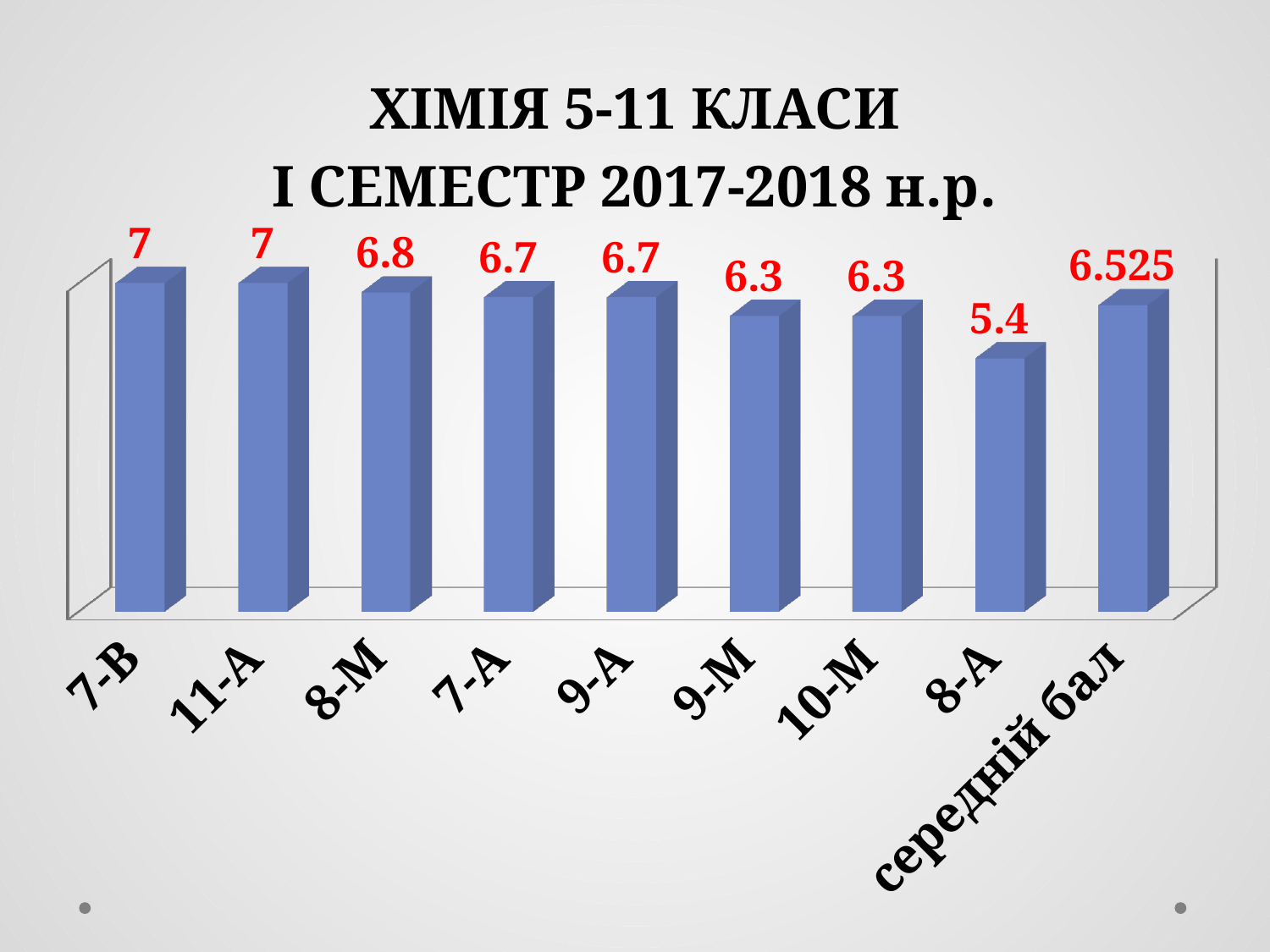
What is the value for 8-А? 5.4 How many categories are shown on the x axis? 9 What is the difference between the values for 8-М and 9-М? 0.5 Which is larger, the value for 8-М or the value for 7-А? 8-М What is the difference between the values for 7-В and 8-А? 1.6 Which category has the lowest value? 8-А What is the title of the chart? ХІМІЯ 5-11 КЛАСИ І СЕМЕСТР 2017-2018 н.р. What is the value for середній бал? 6.525 What is the value for 10-М? 6.3 What is the value for 7-В? 7 What is the value for 8-М? 6.8 What kind of chart is shown on the slide? bar chart